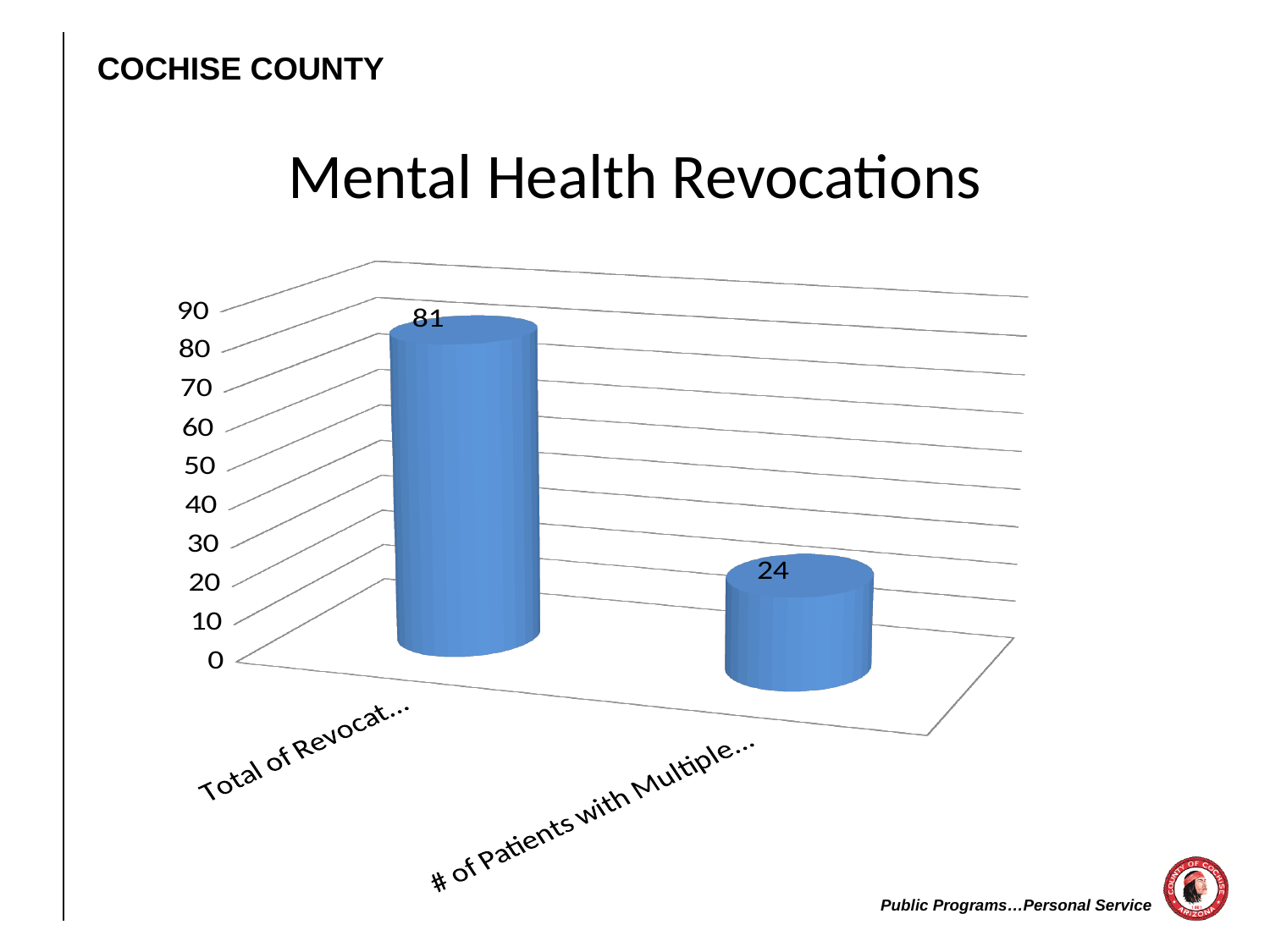
Is the value for "# of Patients with Multiple..." greater or less than 30? less Which category has the lowest value? # of Patients with Multiple... What kind of chart is shown on the slide? Bar chart What is the value of the bar labelled "# of Patients with Multiple..."? 24 What is the difference between the "Total of Revocat..." value and the "# of Patients with Multiple..." value? 57 Which is larger: the value for "Total of Revocat..." or the value for "# of Patients with Multiple..."? Total of Revocat... Do the values rise or fall from left to right along the x axis? Fall How many categories are shown in the chart? 2 Is the value for "Total of Revocat..." greater or less than 70? greater What is the value of the bar labelled "Total of Revocat..."? 81 Which category has the highest value? Total of Revocat... What is the title of the chart? Mental Health Revocations